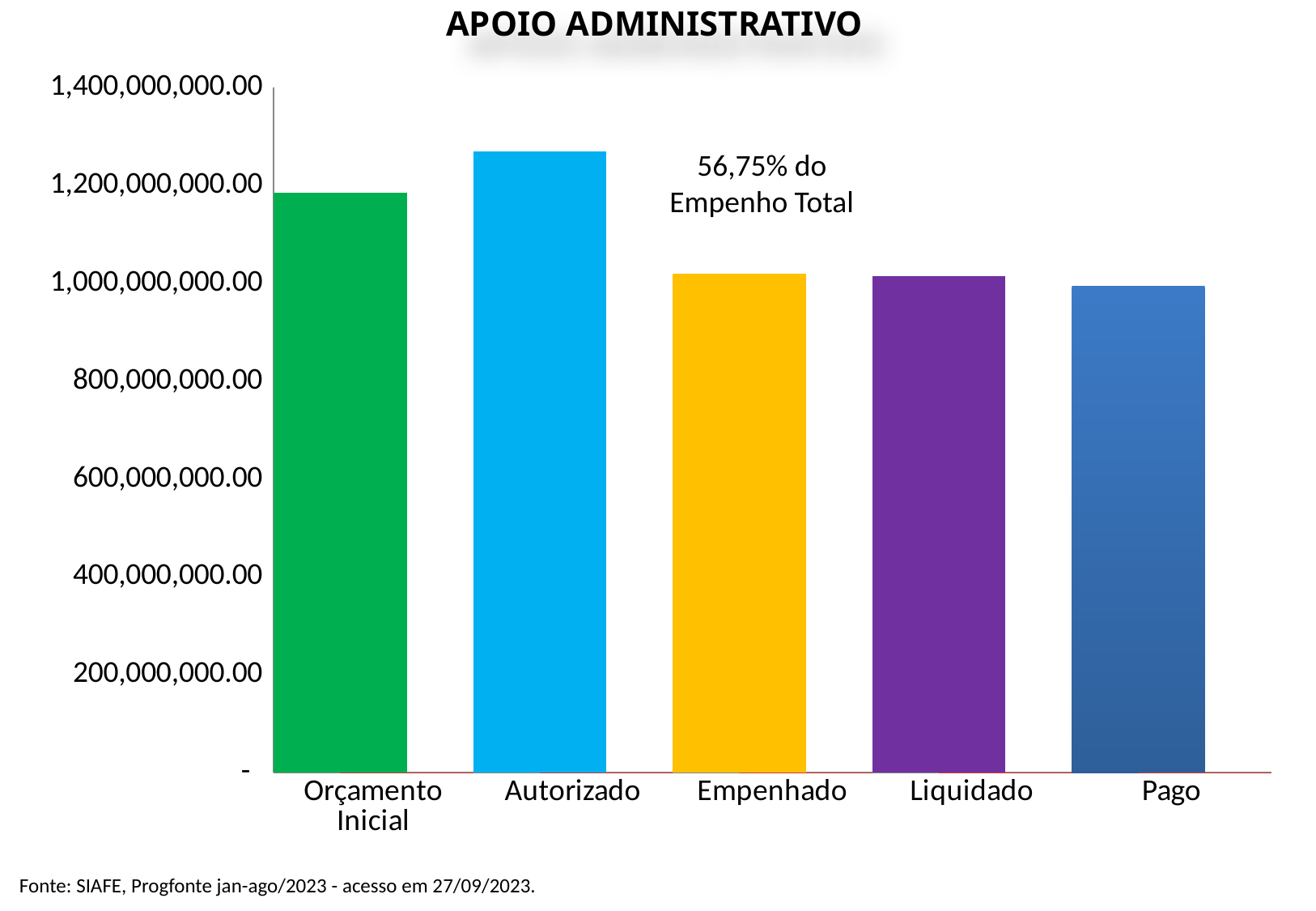
What kind of chart is shown on the slide? bar chart Is the value for Orçamento Inicial greater or less than 1,000,000,000.00? greater What percentage annotation is shown above the Empenhado bar? 56,75% do Empenho Total How many categories are shown on the x axis? 5 Which is larger, the value for Autorizado or the value for Orçamento Inicial? Autorizado Is the value for Pago greater or less than 800,000,000.00? greater Which category has the lowest value? Pago Is the value for Autorizado greater or less than 1,200,000,000.00? greater What is the title of the chart? APOIO ADMINISTRATIVO Which is larger, the value for Orçamento Inicial or the value for Empenhado? Orçamento Inicial Which category has the highest value? Autorizado Do the values rise or fall from Autorizado to Pago along the x axis? fall